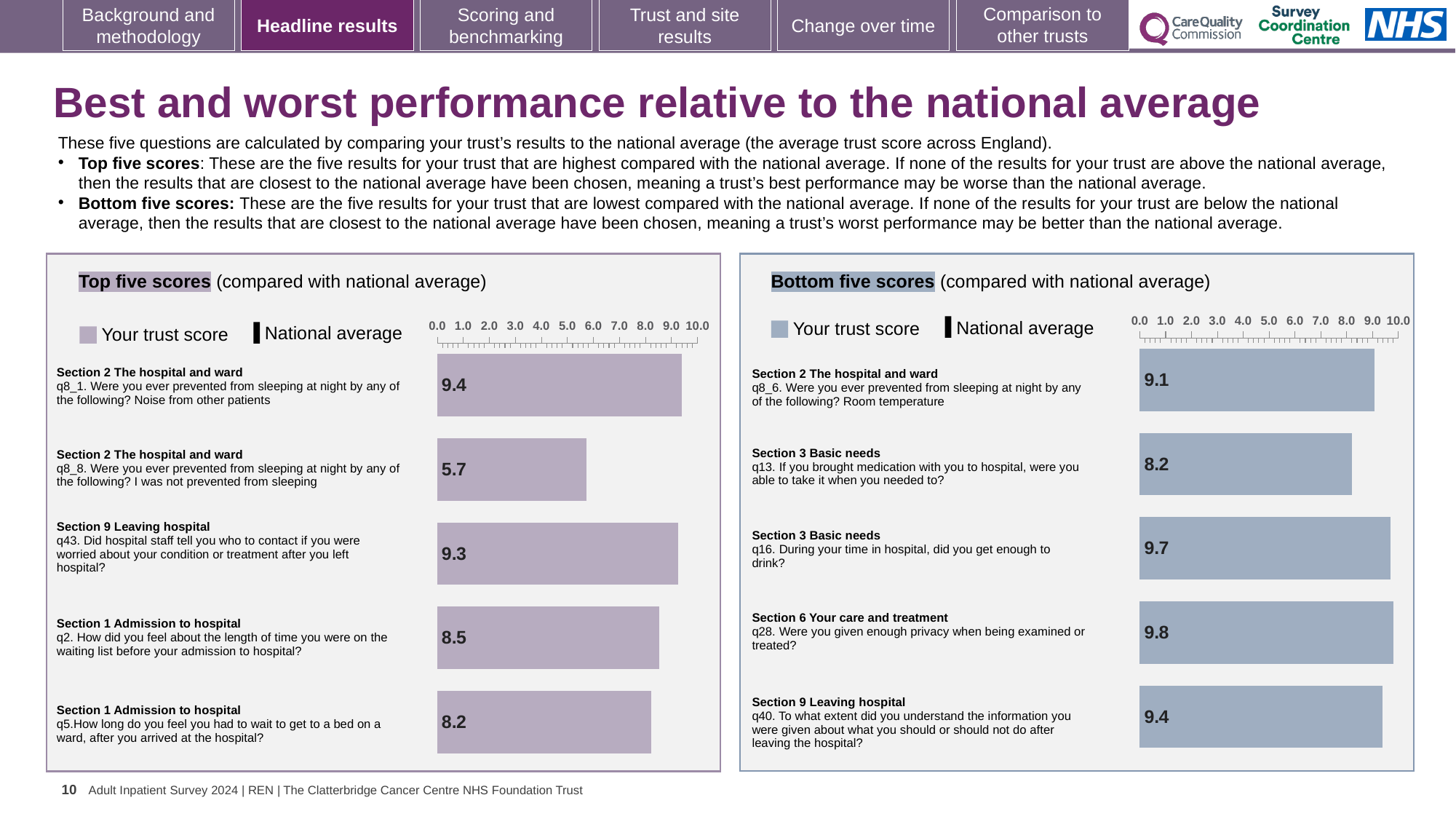
In the Bottom five scores chart, which question has the lowest trust score? q13. If you brought medication with you to hospital, were you able to take it when you needed to? In the Bottom five scores chart, is the score for q8_6 (room temperature) or q40 (understanding information after leaving hospital) larger? q40 In the Bottom five scores chart, what is the difference between the scores for q28 and q13? 1.6 In the Top five scores chart, how many questions are plotted? 5 In the Top five scores chart, which question has the lowest trust score? q8_8. I was not prevented from sleeping In the Bottom five scores chart, what is the trust score for q16 (did you get enough to drink)? 9.7 In the Top five scores chart, what is the difference between the scores for q43 and q5? 1.1 In the Top five scores chart, what is the trust score for q8_1 (prevented from sleeping by noise from other patients)? 9.4 What type of chart is used in the Top five scores panel? Bar chart In the Bottom five scores chart, which question has the highest trust score? q28. Were you given enough privacy when being examined or treated? How many entries does the legend of the Bottom five scores chart list? 2 In the Top five scores chart, what is the trust score for q2 (length of time on the waiting list before admission)? 8.5